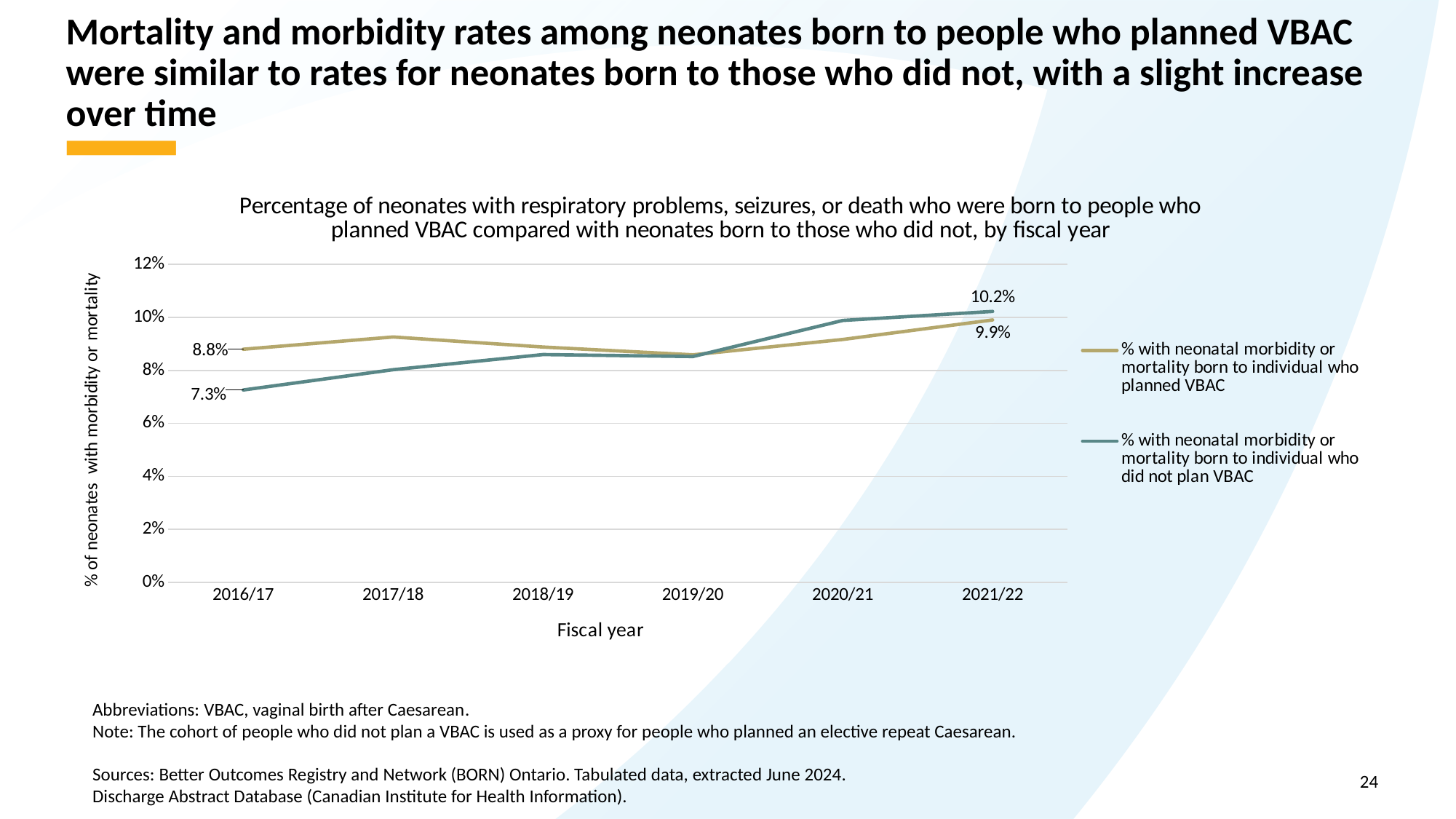
How many series does the legend list? 2 Does the did not plan VBAC series rise or fall from 2016/17 to 2021/22? Rise What is the value for the did not plan VBAC series in 2016/17? 7.3% What kind of chart is shown on the slide? Line chart Is the value for the planned VBAC series in 2017/18 greater or less than 8%? greater What is the value for the planned VBAC series in 2021/22? 9.9% What is the value for the planned VBAC series in 2016/17? 8.8% How many fiscal years are shown on the x axis? 6 What is the value for the did not plan VBAC series in 2021/22? 10.2% By how much did the did not plan VBAC series change from 2016/17 to 2021/22? 2.9 percentage points In 2021/22, which series has the higher value: planned VBAC or did not plan VBAC? Did not plan VBAC What is the difference between the planned VBAC and did not plan VBAC values in 2016/17? 1.5 percentage points